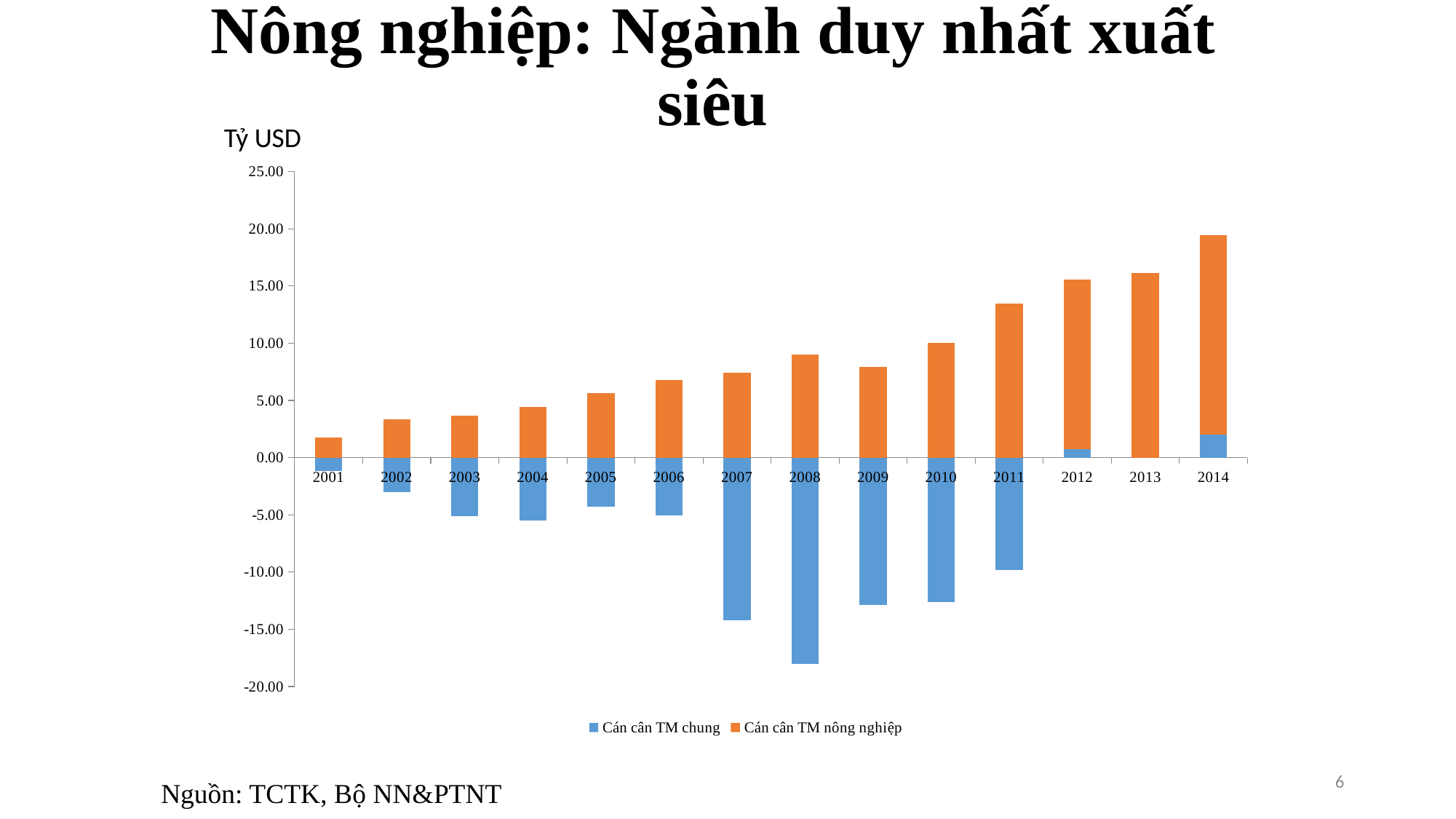
What unit is shown above the vertical axis of the chart? Tỷ USD How many years are shown on the x axis? 14 Is the value for Cán cân TM nông nghiệp in 2001 greater or less than 5.00? less Is the value for Cán cân TM chung in 2007 greater or less than -10.00? less How many series does the legend list? 2 In which year is the value for Cán cân TM chung lowest (most negative)? 2008 Do the values for Cán cân TM nông nghiệp generally rise or fall from 2001 to 2014? Rise In which year is the value for Cán cân TM nông nghiệp highest? 2014 Which year has the larger value for Cán cân TM nông nghiệp, 2013 or 2014? 2014 Is the value for Cán cân TM chung in 2008 greater or less than -15.00? less What kind of chart is shown on the slide? Stacked bar chart